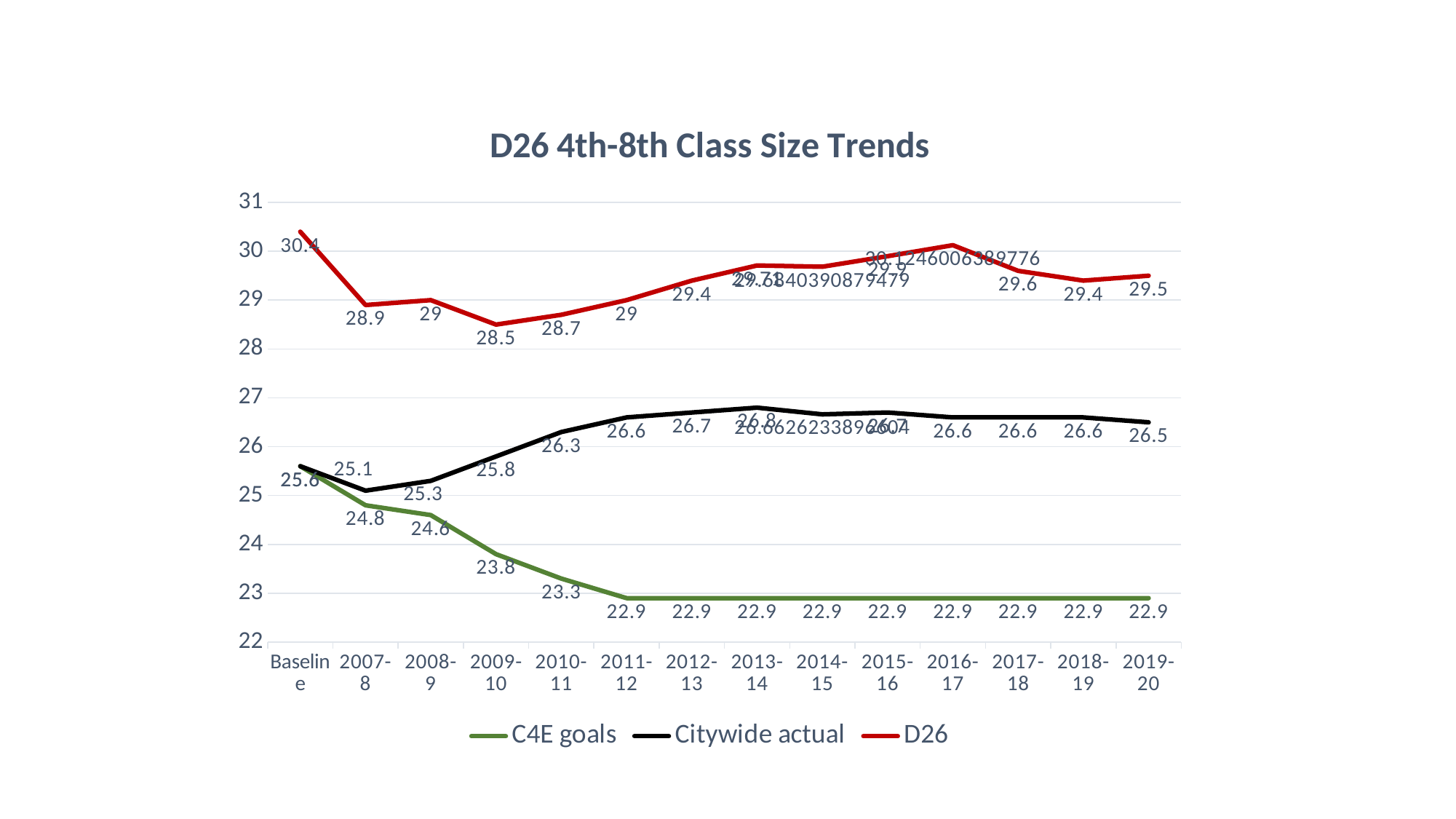
What is the difference between the D26 value at Baseline and in 2007-8? 1.5 In which period is the D26 value lowest? 2009-10 What is the D26 value for 2009-10? 28.5 Is the D26 value for 2016-17 greater or less than 30? greater In 2012-13, which is larger: Citywide actual or C4E goals? Citywide actual Do the C4E goals values rise or fall from Baseline to 2011-12? fall What is the D26 value for 2019-20? 29.5 What is the D26 value at Baseline? 30.4 In which period is the D26 value highest? Baseline What is the C4E goals value for 2009-10? 23.8 What is the Citywide actual value for 2007-8? 25.1 How many series does the legend list? 3